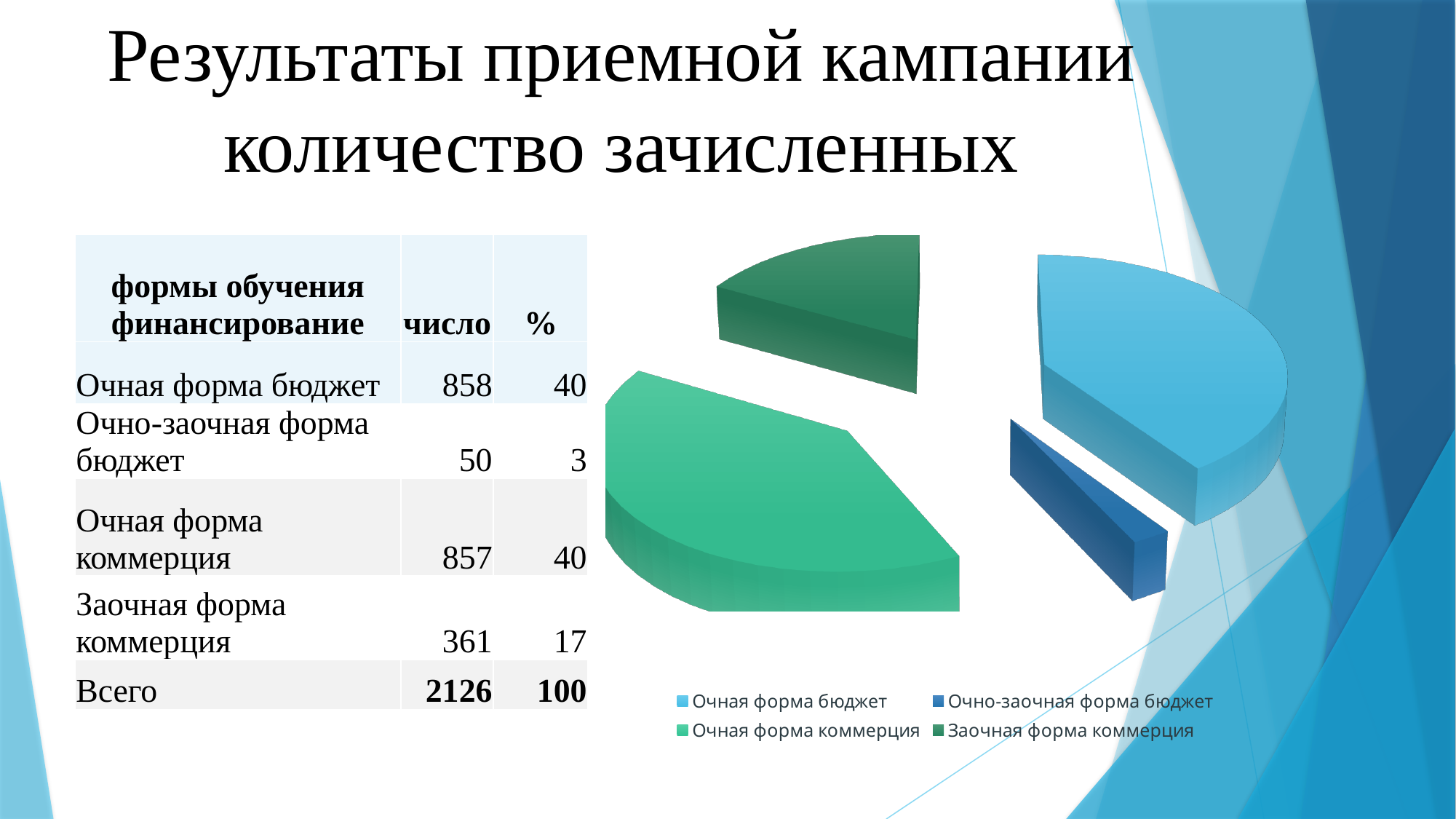
Which slice is larger in the pie chart: Очная форма коммерция or Заочная форма коммерция? Очная форма коммерция According to the table on the slide, what share of the pie does Очно-заочная форма бюджет represent? 3 According to the table on the slide, how many enrolled students does the Очная форма бюджет slice correspond to? 858 Which slice is larger in the pie chart: Очная форма бюджет or Очно-заочная форма бюджет? Очная форма бюджет Which legend entry is shown in light blue in the pie chart? Очная форма бюджет How many slices does the pie chart have? 4 According to the table on the slide, what is the total number of enrolled students represented by the whole pie? 2126 Which slice is larger in the pie chart: Заочная форма коммерция or Очно-заочная форма бюджет? Заочная форма коммерция What kind of chart is shown on the slide? pie chart Which category has the smallest slice in the pie chart? Очно-заочная форма бюджет According to the table on the slide, what share of the pie does Заочная форма коммерция represent? 17 How many entries does the pie chart's legend list? 4